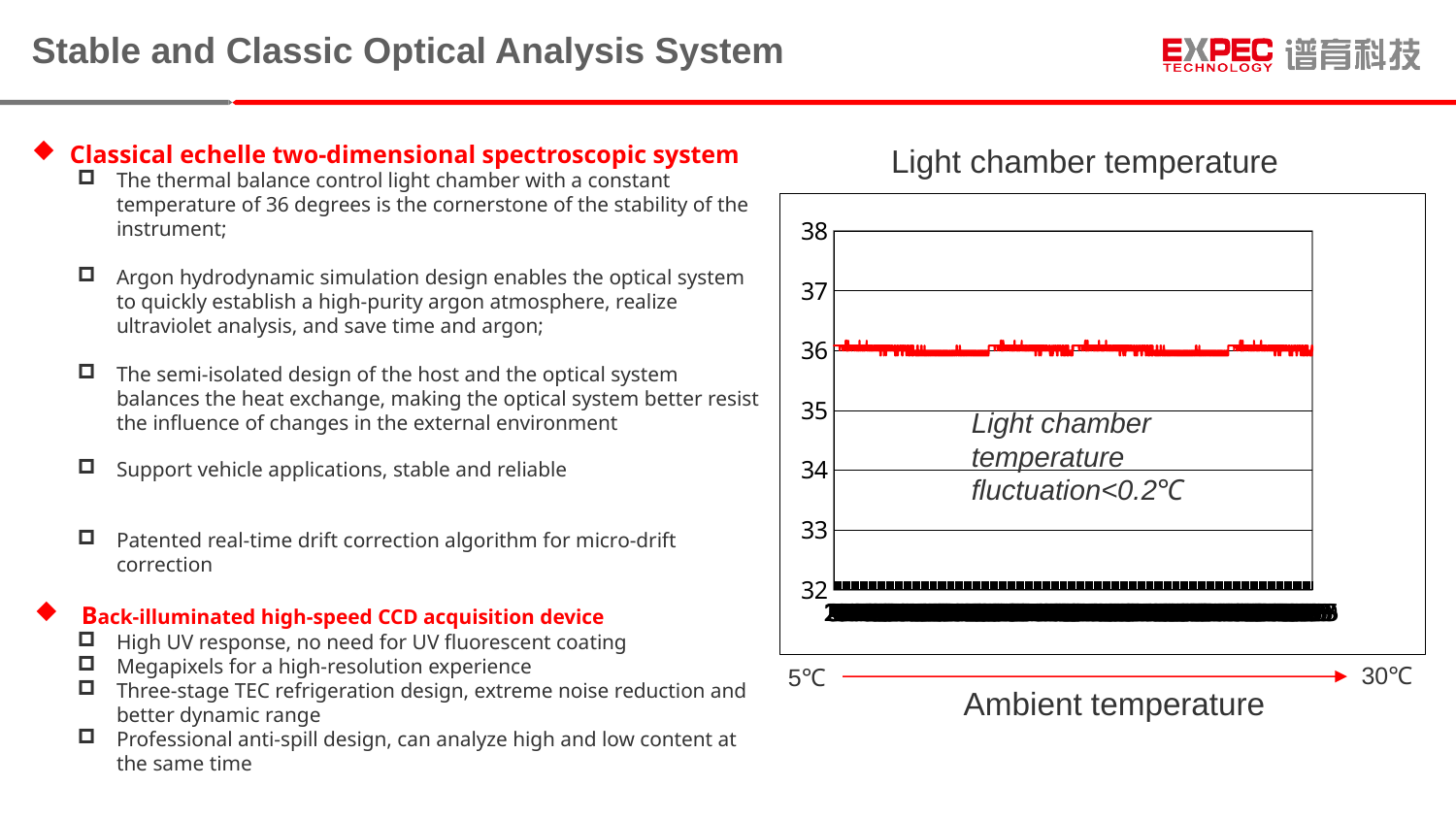
What fluctuation limit is stated in the annotation inside the "Light chamber temperature" chart? <0.2℃ What kind of chart is the "Light chamber temperature" chart? line chart What colour is the plotted temperature line in the "Light chamber temperature" chart? red What is the title of the chart on the right side of the slide? Light chamber temperature In the "Light chamber temperature" chart, is the plotted temperature greater or less than 35? greater In the "Light chamber temperature" chart, is the plotted temperature greater or less than 33? greater In the "Light chamber temperature" chart, does the plotted temperature rise, fall, or stay roughly flat along the x axis? stays roughly flat In the "Light chamber temperature" chart, is the plotted temperature greater or less than 37? less